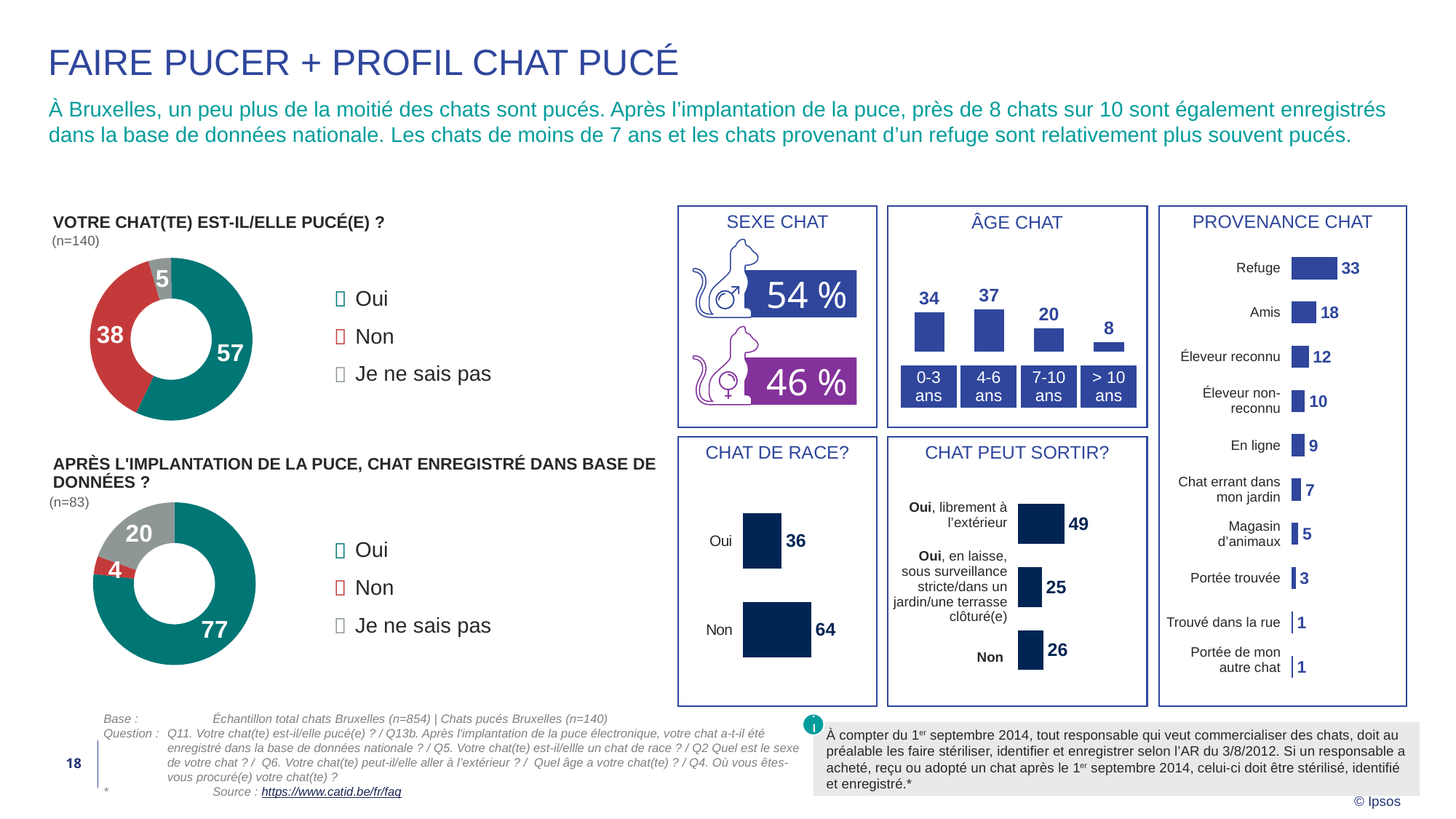
In the 'ÂGE CHAT' chart, which age group has the lowest value? > 10 ans In the 'PROVENANCE CHAT' chart, what is the value for 'Amis'? 18 What kind of chart is the 'PROVENANCE CHAT' chart? Bar chart In the 'VOTRE CHAT(TE) EST-IL/ELLE PUCÉ(E) ?' donut chart, what is the value for 'Oui'? 57 In the 'ÂGE CHAT' chart, what is the value for '4-6 ans'? 37 In the 'VOTRE CHAT(TE) EST-IL/ELLE PUCÉ(E) ?' donut chart, what is the value for 'Je ne sais pas'? 5 How many age groups are shown in the 'ÂGE CHAT' chart? 4 In the 'PROVENANCE CHAT' chart, which category has the highest value? Refuge In the 'APRÈS L'IMPLANTATION DE LA PUCE, CHAT ENREGISTRÉ DANS BASE DE DONNÉES ?' donut chart, which category has the highest value? Oui In the 'CHAT PEUT SORTIR?' chart, which is larger: 'Non' or 'Oui, en laisse, sous surveillance stricte/dans un jardin/une terrasse clôturé(e)'? Non In the 'APRÈS L'IMPLANTATION DE LA PUCE, CHAT ENREGISTRÉ DANS BASE DE DONNÉES ?' donut chart, what is the difference between 'Oui' and 'Je ne sais pas'? 57 In the 'CHAT DE RACE?' chart, what is the difference between 'Non' and 'Oui'? 28